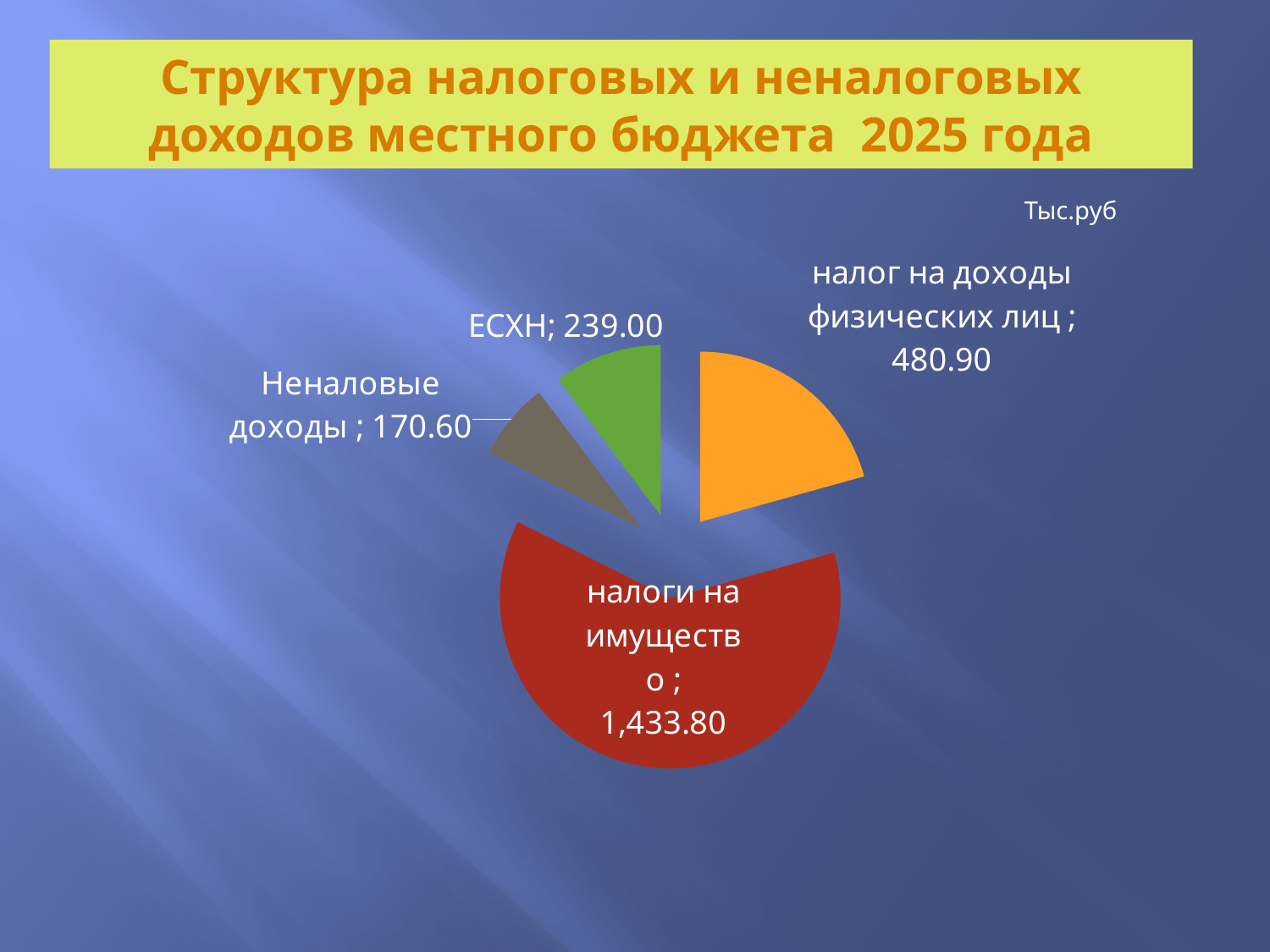
What is the value for налог на доходы физических лиц? 480.90 What is the value for Неналовые доходы? 170.60 What is the value for ЕСХН? 239.00 What is the value for налоги на имущество? 1,433.80 Which category has the smallest slice of the pie? Неналовые доходы How many slices does the pie chart have? 4 What kind of chart is shown on the slide? pie chart What unit is indicated for the values on the chart? Тыс.руб Which category has the largest slice of the pie? налоги на имущество What is the difference between налог на доходы физических лиц and ЕСХН? 241.90 What share of the pie does налоги на имущество represent? 61.7% Which is larger, ЕСХН or Неналовые доходы? ЕСХН